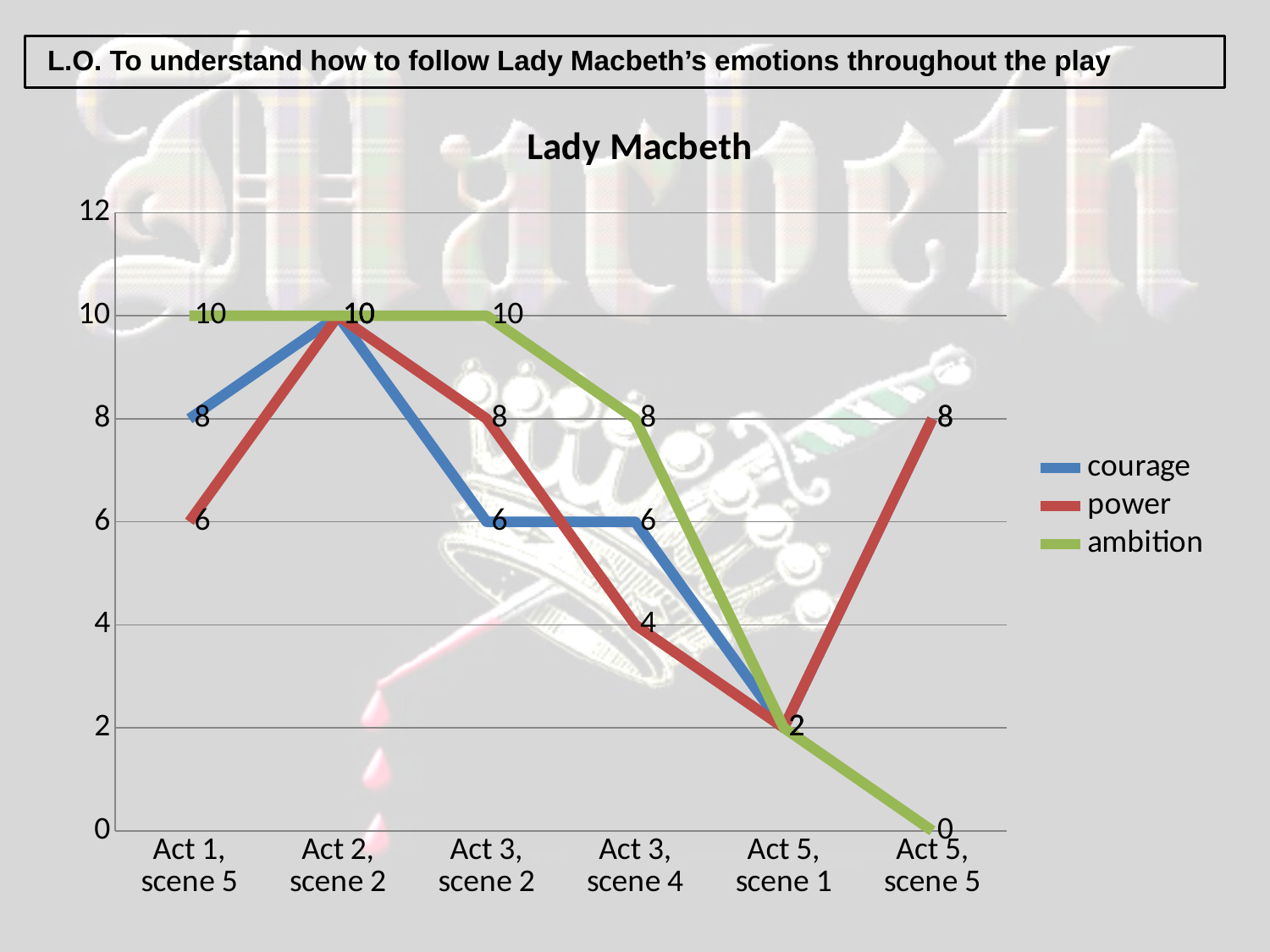
What is the title of the chart? Lady Macbeth By how much does the power value rise from Act 5, scene 1 to Act 5, scene 5? 6 What kind of chart is shown on the slide? line chart At which scene is the ambition value lowest? Act 5, scene 5 At Act 1, scene 5, which is higher: courage or power? courage How many series does the legend list? 3 What is the ambition value at Act 5, scene 5? 0 What is the ambition value at Act 1, scene 5? 10 What is the power value at Act 5, scene 5? 8 What is the courage value at Act 3, scene 2? 6 What is the power value at Act 3, scene 4? 4 How many scenes are plotted along the x axis? 6